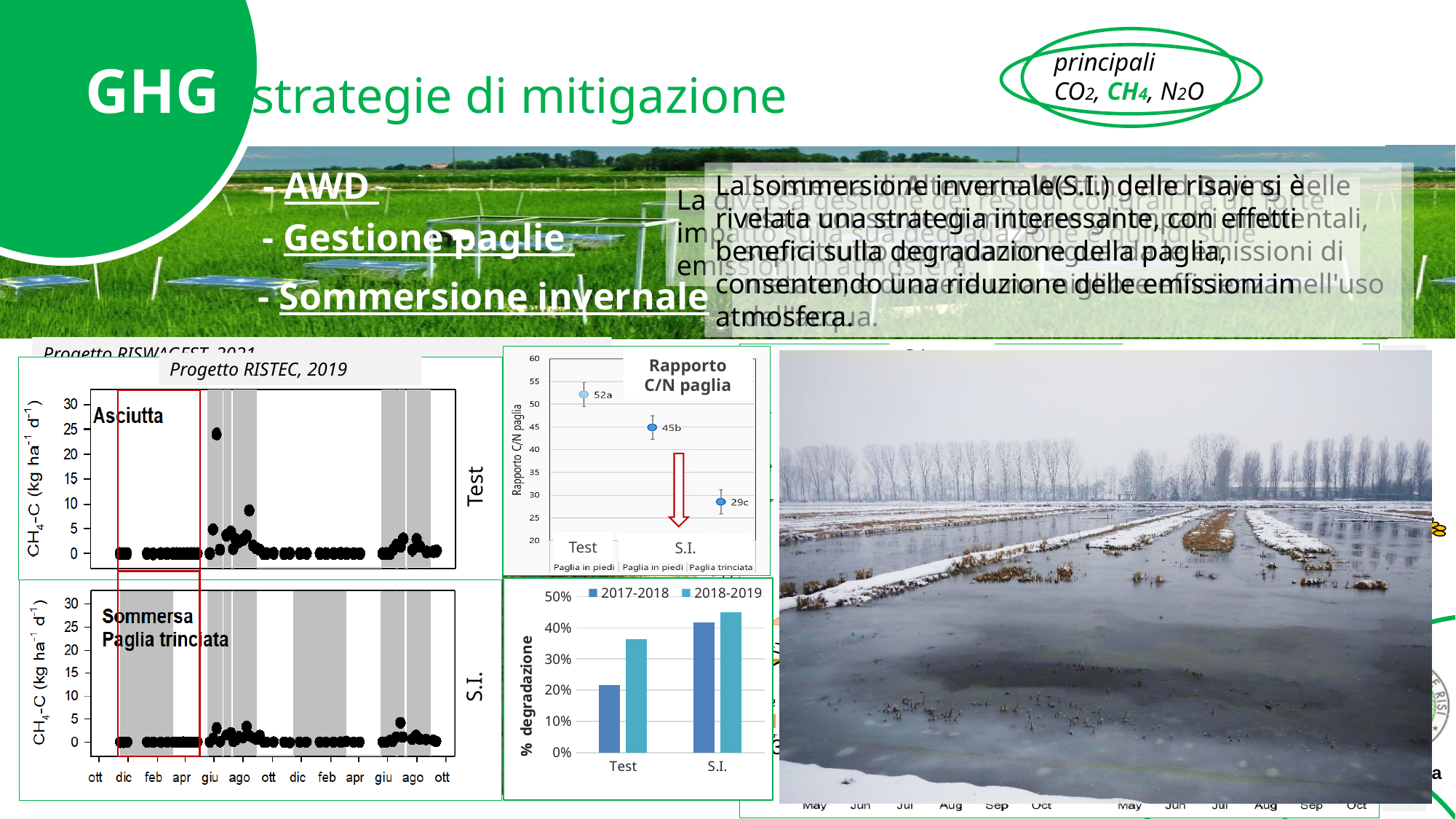
In the '% degradazione' chart, is the 2018-2019 value for S.I. greater or less than 40%? greater In the 'Rapporto C/N paglia' chart, what is the value labelled for the Test (Paglia in piedi) point? 52a In the 'Rapporto C/N paglia' chart, what is the value labelled for the S.I. Paglia in piedi point? 45b How many series does the legend of the '% degradazione' chart list? 2 In the '% degradazione' chart, which series are listed in the legend? 2017-2018 and 2018-2019 In the 'Rapporto C/N paglia' chart, how many data points are plotted? 3 In the 'Rapporto C/N paglia' chart, what is the difference between the Test Paglia in piedi value (52) and the S.I. Paglia trinciata value (29)? 23 In the '% degradazione' chart, which is larger for 2018-2019: Test or S.I.? S.I. In the 'Rapporto C/N paglia' chart, which point has the lowest value? S.I. Paglia trinciata (29c) What kind of chart is the '% degradazione' chart at the bottom centre of the slide? bar chart In the 'Rapporto C/N paglia' chart, what is the value labelled for the S.I. Paglia trinciata point? 29c In the '% degradazione' chart, is the 2018-2019 value for Test greater or less than 30%? greater